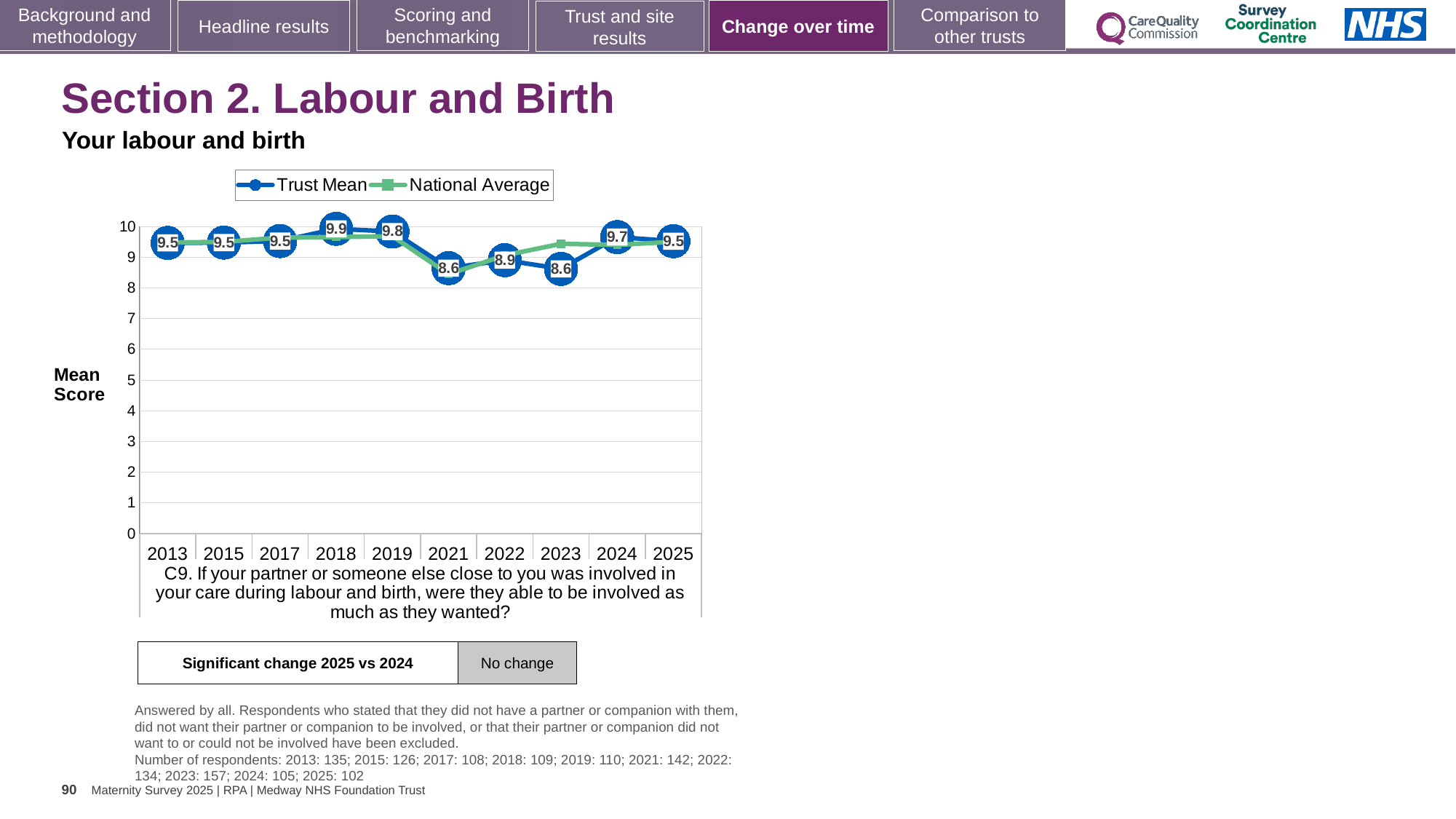
What is the Trust Mean score for 2025? 9.5 What is the Trust Mean score for 2018? 9.9 Is the National Average value for 2023 greater or less than 9? greater In which year is the Trust Mean score highest? 2018 How many years are plotted on the x axis? 10 What is the Trust Mean score for 2022? 8.9 How many series does the legend list? 2 What is the lowest Trust Mean score shown on the chart? 8.6 Which year has the larger Trust Mean score, 2024 or 2023? 2024 What is the difference between the Trust Mean scores for 2018 and 2021? 1.3 What kind of chart is shown on the slide? Line chart Does the Trust Mean score rise or fall from 2019 to 2021? Fall